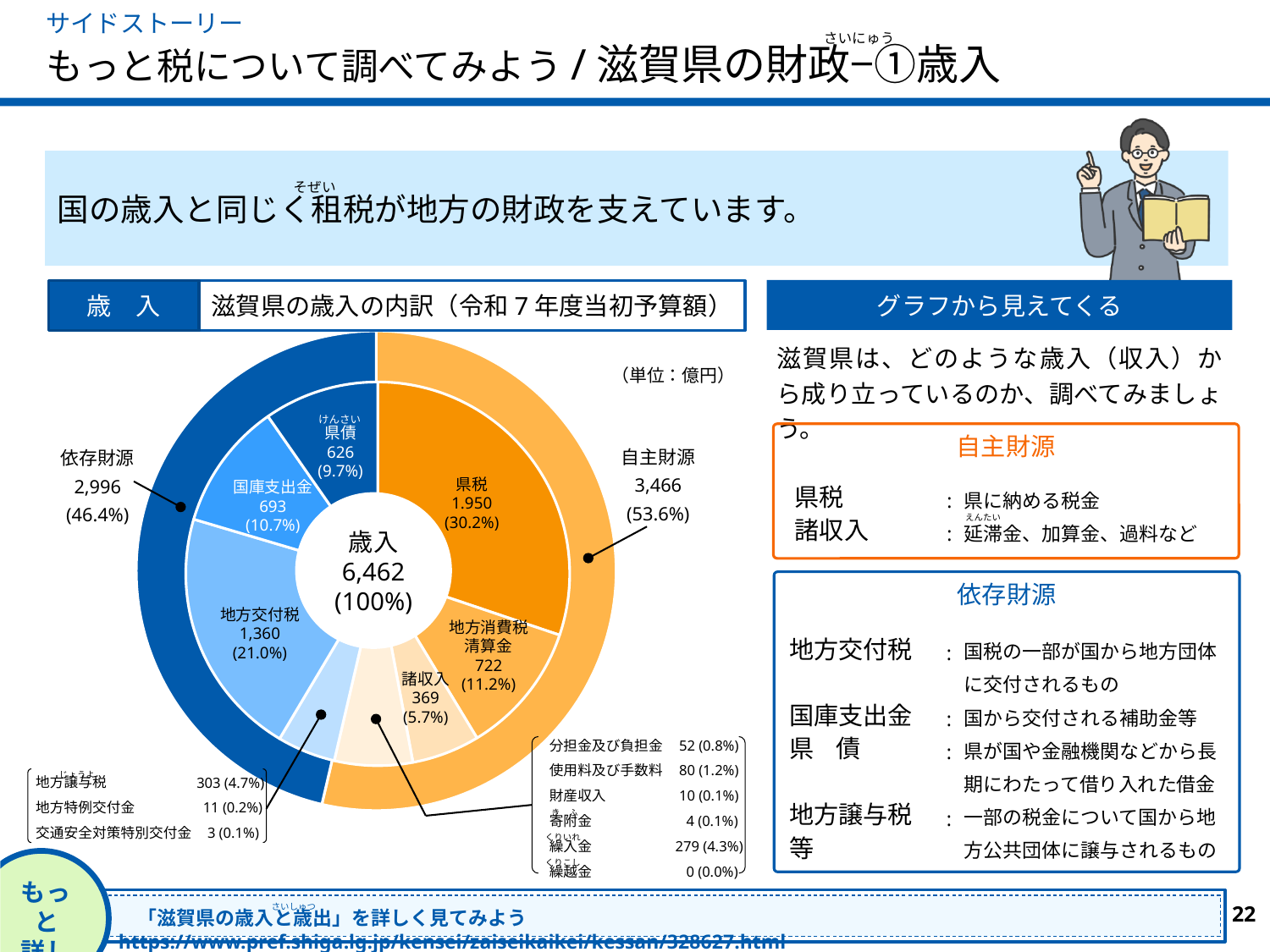
What is the total revenue (歳入) shown in the centre of the chart? 6,462 What is the value for 諸収入 in the chart? 369 What is the value for 地方消費税清算金 in the chart? 722 What percentage share does 県税 have in the chart? 30.2% What is the value for 地方交付税 in the chart? 1,360 What is the difference between 自主財源 (3,466) and 依存財源 (2,996) in the chart? 470 What is the value for 自主財源 in the chart? 3,466 What kind of chart is used to show the breakdown of Shiga Prefecture's revenue (滋賀県の歳入の内訳)? Pie (doughnut) chart What unit is stated for the values in the chart? 億円 Which is larger in the chart, 国庫支出金 or 県債? 国庫支出金 What is the value for 地方譲与税 listed in the chart's callout? 303 (4.7%) What percentage share does 依存財源 have in the chart? 46.4%